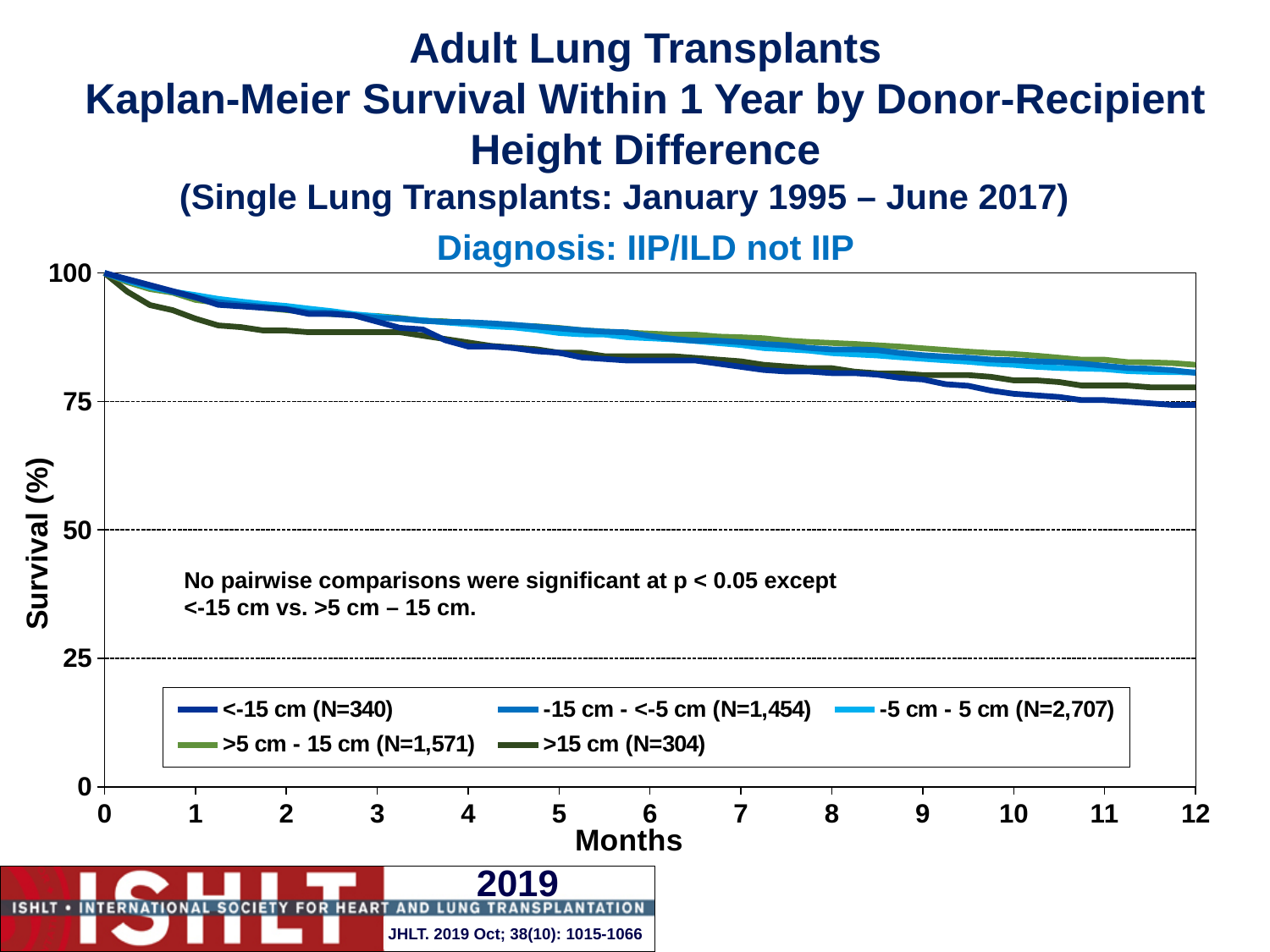
Is the survival for the >5 cm - 15 cm group at 12 months greater or less than 75? greater How many series does the legend list? 5 Do the survival curves rise or fall as months increase? Fall Is the survival for the <-15 cm group at 6 months greater or less than 75? greater What kind of chart is shown on the slide? Line chart What is the N for the <-15 cm group shown in the legend? N=340 What is the label of the x axis? Months Which group has the lowest survival at 12 months? <-15 cm What is the N for the -5 cm - 5 cm group shown in the legend? N=2,707 Which group has the lowest survival at 1 month? >15 cm At 12 months, is survival higher for the >5 cm - 15 cm group or the <-15 cm group? >5 cm - 15 cm Is the survival for the >15 cm group at 1 month greater or less than 75? greater